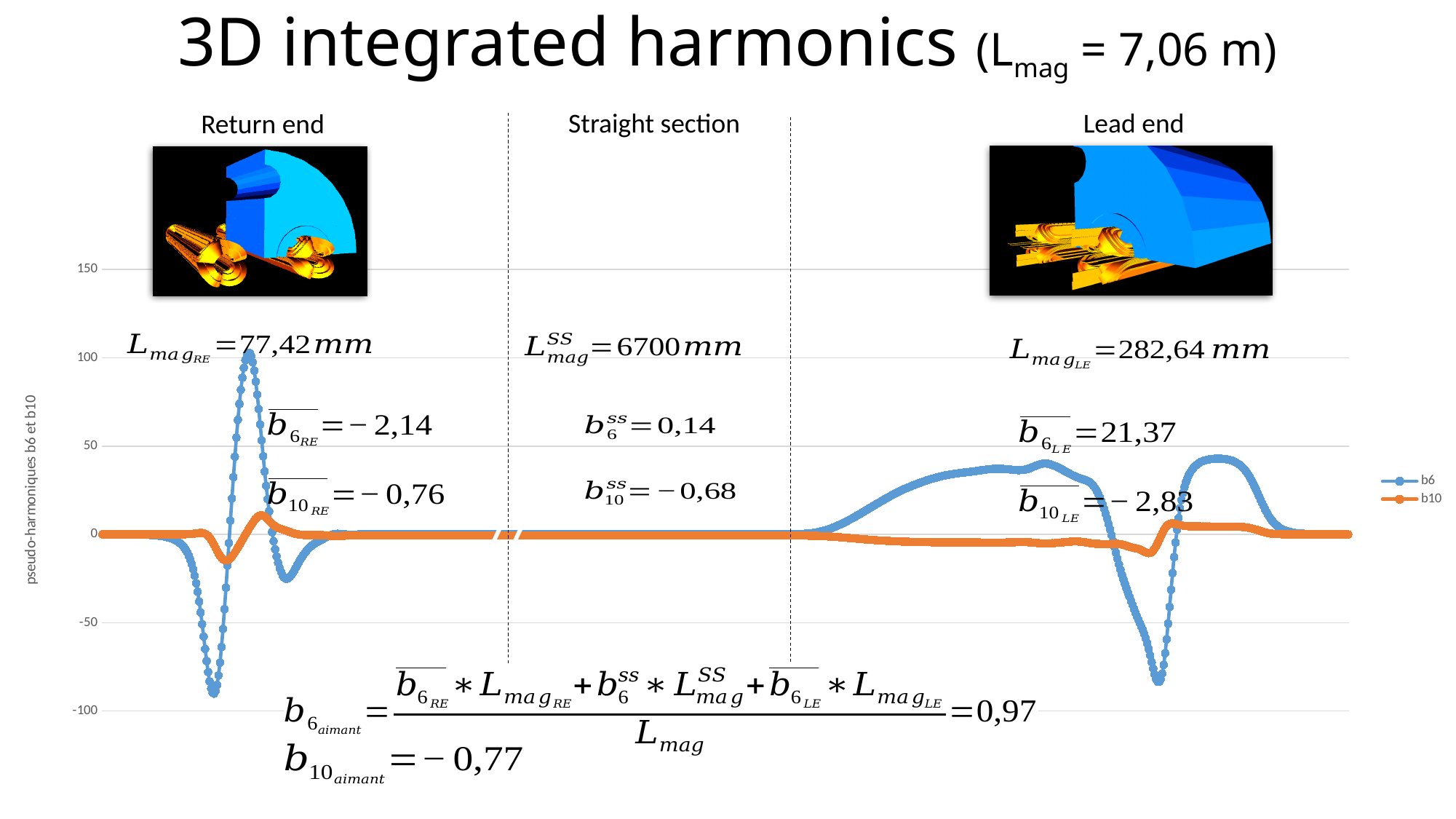
What are the two series named in the chart legend? b6 and b10 Is the lowest value of the b6 series in the Return end region greater or less than -50? less Which series reaches the lower minimum value in the Lead end region, b6 or b10? b6 Is the highest value of the b10 series anywhere on the chart greater or less than 50? less What kind of chart is shown on the slide? line chart How many series does the chart legend list? 2 What is the title of the vertical axis of the chart? pseudo-harmoniques b6 et b10 Is the highest value of the b6 series in the Lead end region greater or less than 50? less Which series reaches the higher peak value in the Return end region, b6 or b10? b6 What is the highest tick value shown on the vertical axis? 150